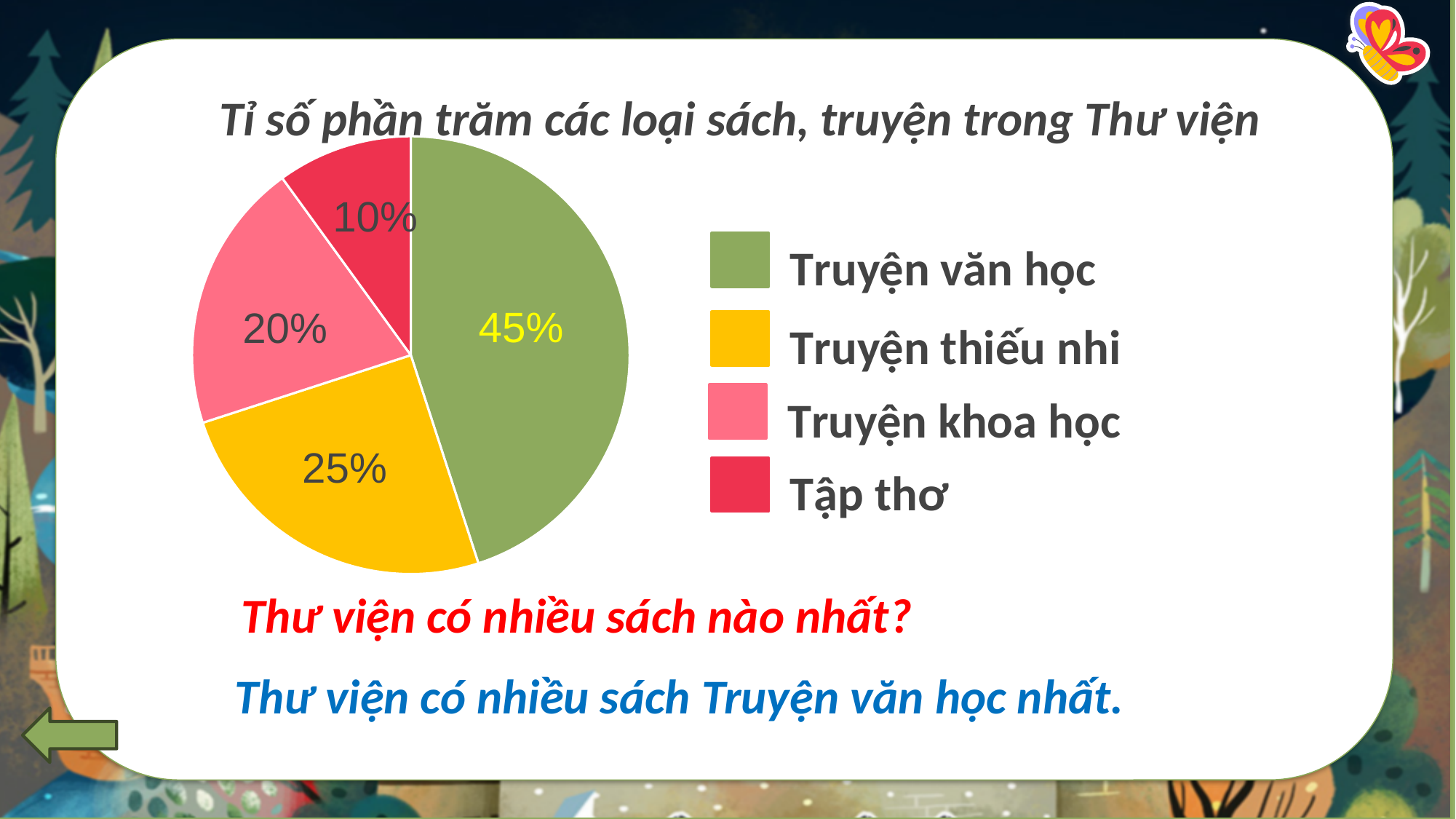
How many categories does the pie chart show? 4 What percentage of the pie is Truyện thiếu nhi? 25% Which category has the largest share of the pie? Truyện văn học What percentage of the pie is Truyện khoa học? 20% What percentage of the pie is Tập thơ? 10% What percentage of the pie is Truyện văn học? 45% What colour is the slice for Truyện thiếu nhi? yellow Which category has the smallest share of the pie? Tập thơ What is the difference in percentage points between Truyện văn học and Truyện thiếu nhi? 20% What is the title of the chart? Tỉ số phần trăm các loại sách, truyện trong Thư viện Which is larger, the share for Truyện khoa học or the share for Tập thơ? Truyện khoa học What type of chart is shown on the slide? pie chart